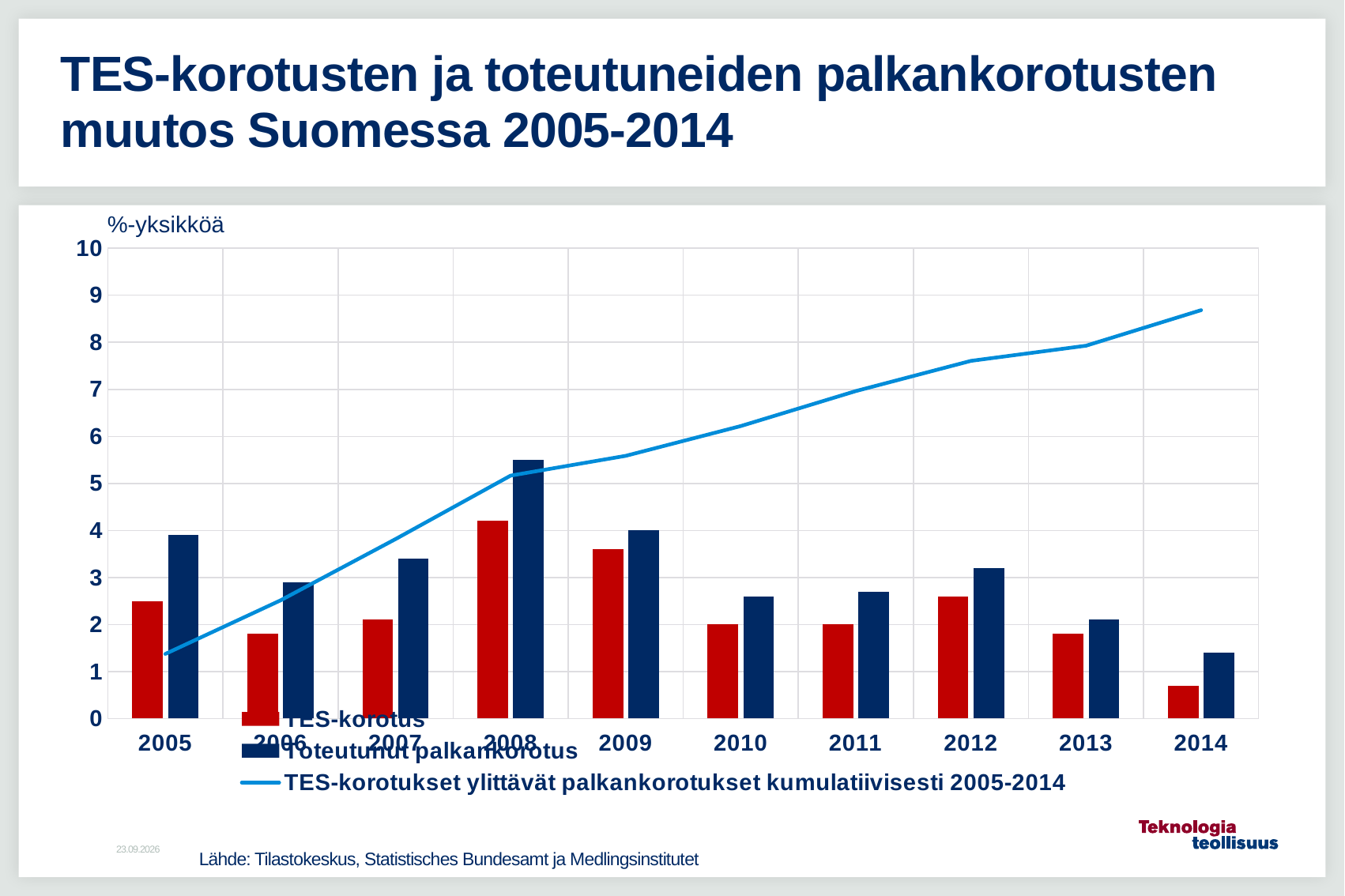
In which year is the Toteutunut palkankorotus bar lowest? 2014 Is the value of the cumulative line (TES-korotukset ylittävät palkankorotukset kumulatiivisesti) in 2014 greater or less than 8? greater Is the Toteutunut palkankorotus value for 2008 greater or less than 5? greater In which year is the Toteutunut palkankorotus bar highest? 2008 Which is larger, the TES-korotus value for 2009 or for 2010? 2009 Is the TES-korotus value for 2008 greater or less than 4? greater How many series does the legend list? 3 In which year is the TES-korotus bar lowest? 2014 What kind of chart is shown on the slide? A combined bar and line chart In which year is the TES-korotus bar highest? 2008 Does the cumulative line (TES-korotukset ylittävät palkankorotukset kumulatiivisesti 2005-2014) rise or fall from 2005 to 2014? It rises How many years are shown on the x axis? 10